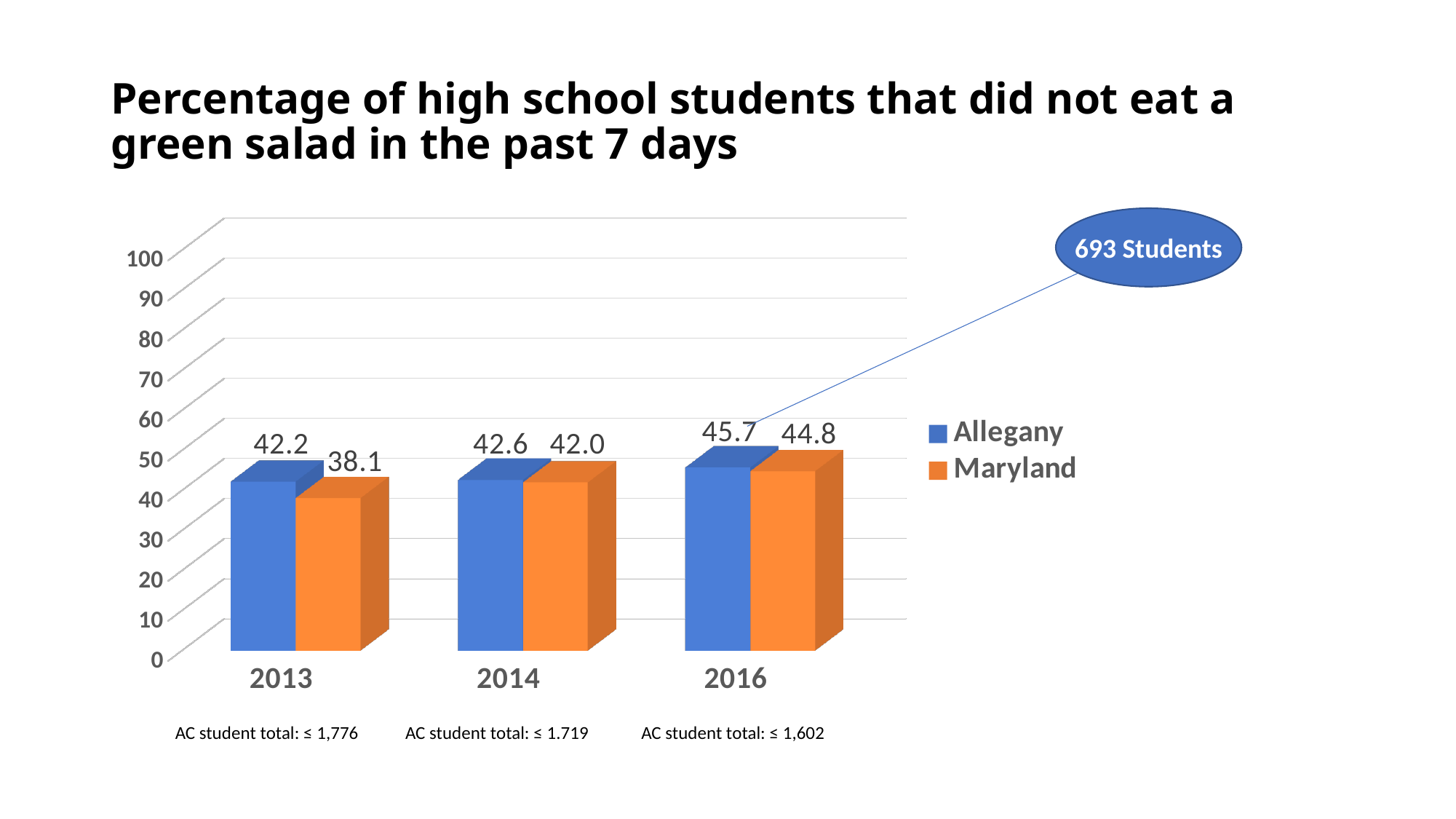
What is the Maryland value for 2014? 42.0 How many years are shown on the x axis? 3 Which year has the lowest Maryland value? 2013 What is the Allegany value for 2013? 42.2 What is the difference between the Allegany and Maryland values in 2013? 4.1 What number of students does the callout bubble point to for the 2016 Allegany bar? 693 Students What is the Maryland value for 2016? 44.8 Do the Allegany values rise or fall from 2013 to 2016? Rise Which year has the highest Allegany value? 2016 How many series does the legend list? 2 What kind of chart is shown on the slide? Bar chart Which is larger in 2016, the Allegany value or the Maryland value? Allegany